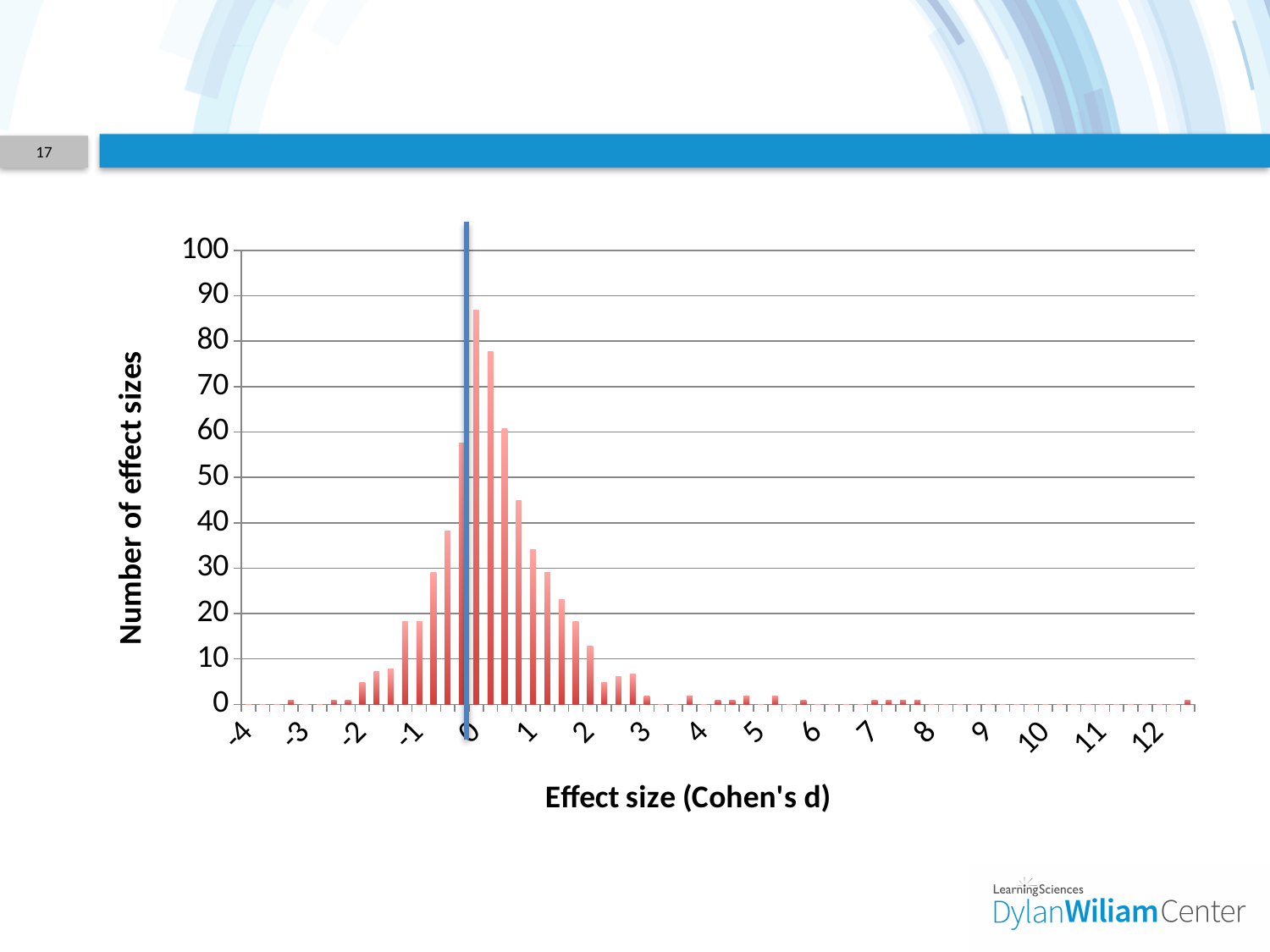
What kind of chart is shown on the slide? bar chart Is the value of the tallest bar greater or less than 80? greater What is the title of the x axis of the chart? Effect size (Cohen's d) Is the bar just to the left of the blue vertical line at 0 greater or less than 50? greater What is the title of the y axis of the chart? Number of effect sizes Are the bars at effect sizes of 4 and above greater or less than 10? less Do the bar heights rise or fall as the effect size increases from -2 to 0? rise Do the bar heights rise or fall as the effect size increases from 1 to 3? fall Are the bars around effect size 1 taller or shorter than the bars around effect size -2? taller